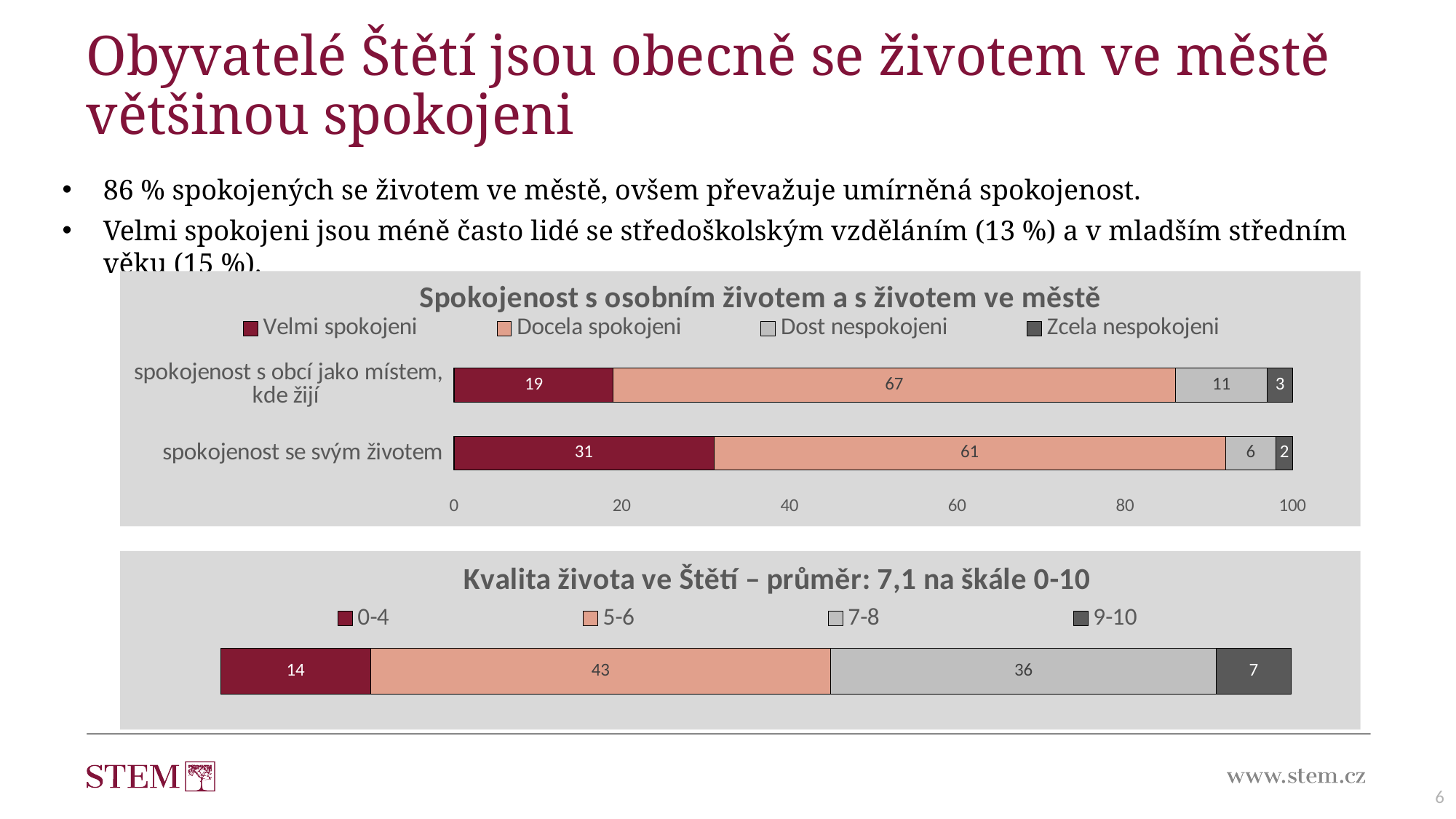
In the chart 'Spokojenost s osobním životem a s životem ve městě', what is the difference between the 'Velmi spokojeni' values for 'spokojenost se svým životem' and 'spokojenost s obcí jako místem, kde žijí'? 12 In the chart 'Kvalita života ve Štětí – průměr: 7,1 na škále 0-10', what is the total of the stacked bar? 100 In the chart 'Spokojenost s osobním životem a s životem ve městě', which category has the larger 'Zcela nespokojeni' value? spokojenost s obcí jako místem, kde žijí In the chart 'Spokojenost s osobním životem a s životem ve městě', what is the value of 'Velmi spokojeni' for 'spokojenost se svým životem'? 31 In the chart 'Kvalita života ve Štětí – průměr: 7,1 na škále 0-10', which segment has the lowest value? 9-10 How many series does the legend of the chart 'Spokojenost s osobním životem a s životem ve městě' list? 4 In the chart 'Kvalita života ve Štětí – průměr: 7,1 na škále 0-10', what is the value for '5-6'? 43 In the chart 'Spokojenost s osobním životem a s životem ve městě', what is the value of 'Dost nespokojeni' for 'spokojenost s obcí jako místem, kde žijí'? 11 What kind of chart is the chart 'Kvalita života ve Štětí – průměr: 7,1 na škále 0-10'? stacked bar chart In the chart 'Kvalita života ve Štětí – průměr: 7,1 na škále 0-10', what is the difference between the '5-6' and '7-8' values? 7 In the chart 'Spokojenost s osobním životem a s životem ve městě', what is the value of 'Docela spokojeni' for 'spokojenost s obcí jako místem, kde žijí'? 67 How many categories are shown in the chart 'Spokojenost s osobním životem a s životem ve městě'? 2